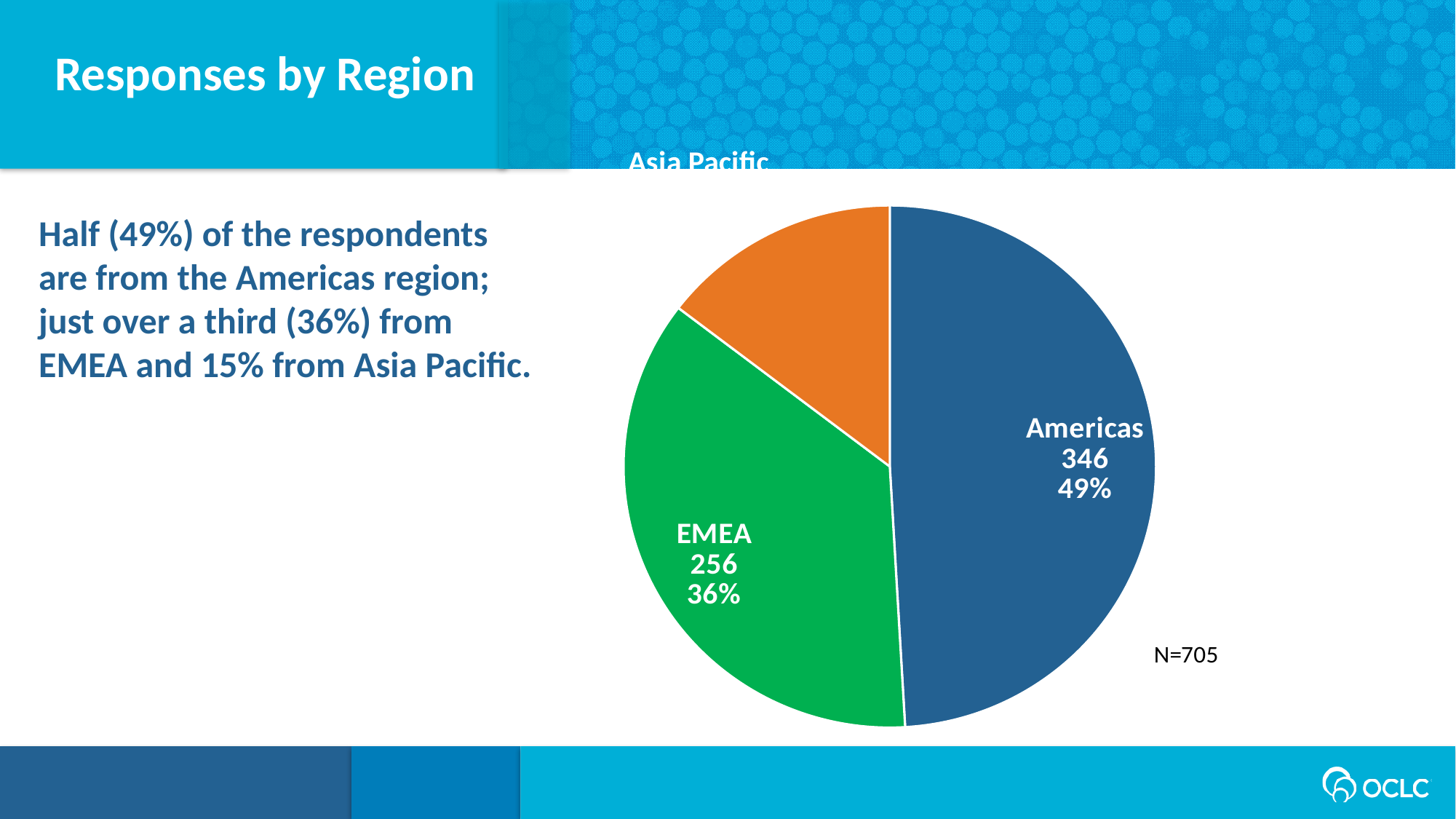
What share of respondents are from Asia Pacific? 15% How many more respondents are from the Americas than from EMEA? 90 What share of the pie does the EMEA slice represent? 36% What share of the pie does the Americas slice represent? 49% Which region has more respondents, EMEA or Asia Pacific? EMEA How many regions are shown in the pie chart? 3 Which region has the smallest slice of the pie? Asia Pacific Which region has the largest slice of the pie? Americas What type of chart is shown on the slide? pie chart What is the total number of respondents (N) shown on the chart? N=705 How many respondents are from EMEA? 256 How many respondents are from the Americas region? 346